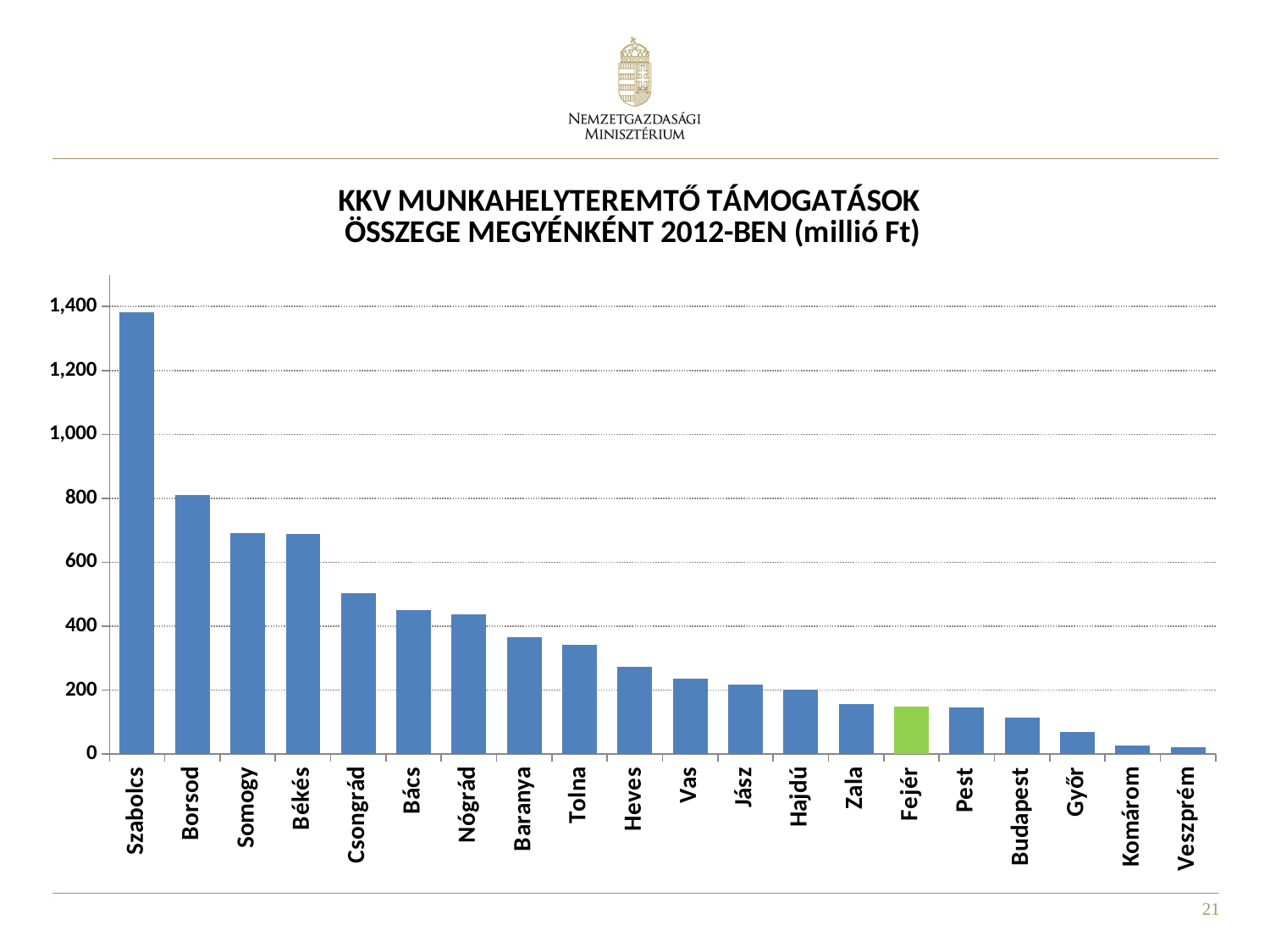
Which county has the highest value? Szabolcs What kind of chart is shown on the slide? bar chart Is the value for Baranya greater or less than 400? less How many counties (categories) are shown on the x axis? 20 Is the value for Győr greater or less than 200? less Which is larger, the value for Heves or the value for Zala? Heves Is the value for Somogy greater or less than 600? greater Which is larger, the value for Borsod or the value for Somogy? Borsod Which county's bar is shown in a different colour (green) from the others? Fejér Do the values rise or fall from left to right along the x axis? fall